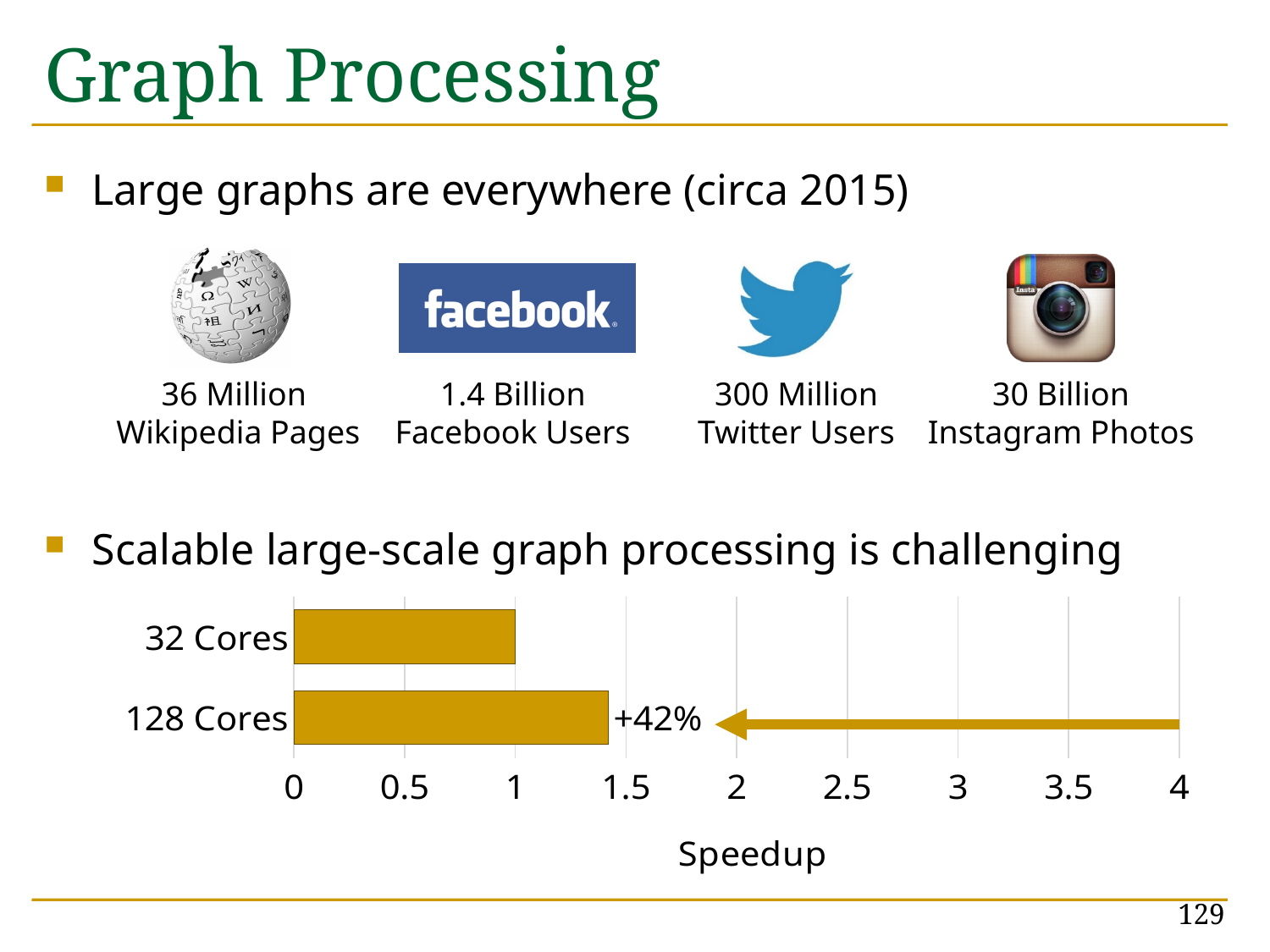
Which category has the lowest speedup in the bar chart? 32 Cores Is the speedup for 128 Cores greater or less than 2? less Which is larger in the bar chart, the speedup for 32 Cores or for 128 Cores? 128 Cores How many categories does the Speedup bar chart show? 2 What is the speedup value for 32 Cores in the bar chart? 1 What is the label on the x axis of the bar chart? Speedup What is the highest value shown on the x axis of the bar chart? 4 What percentage annotation is printed next to the 128 Cores bar? +42% Is the speedup for 128 Cores greater or less than 1? greater Which category has the highest speedup in the bar chart? 128 Cores Is the speedup for 128 Cores greater or less than 1.5? less What kind of chart is shown at the bottom of the slide? bar chart